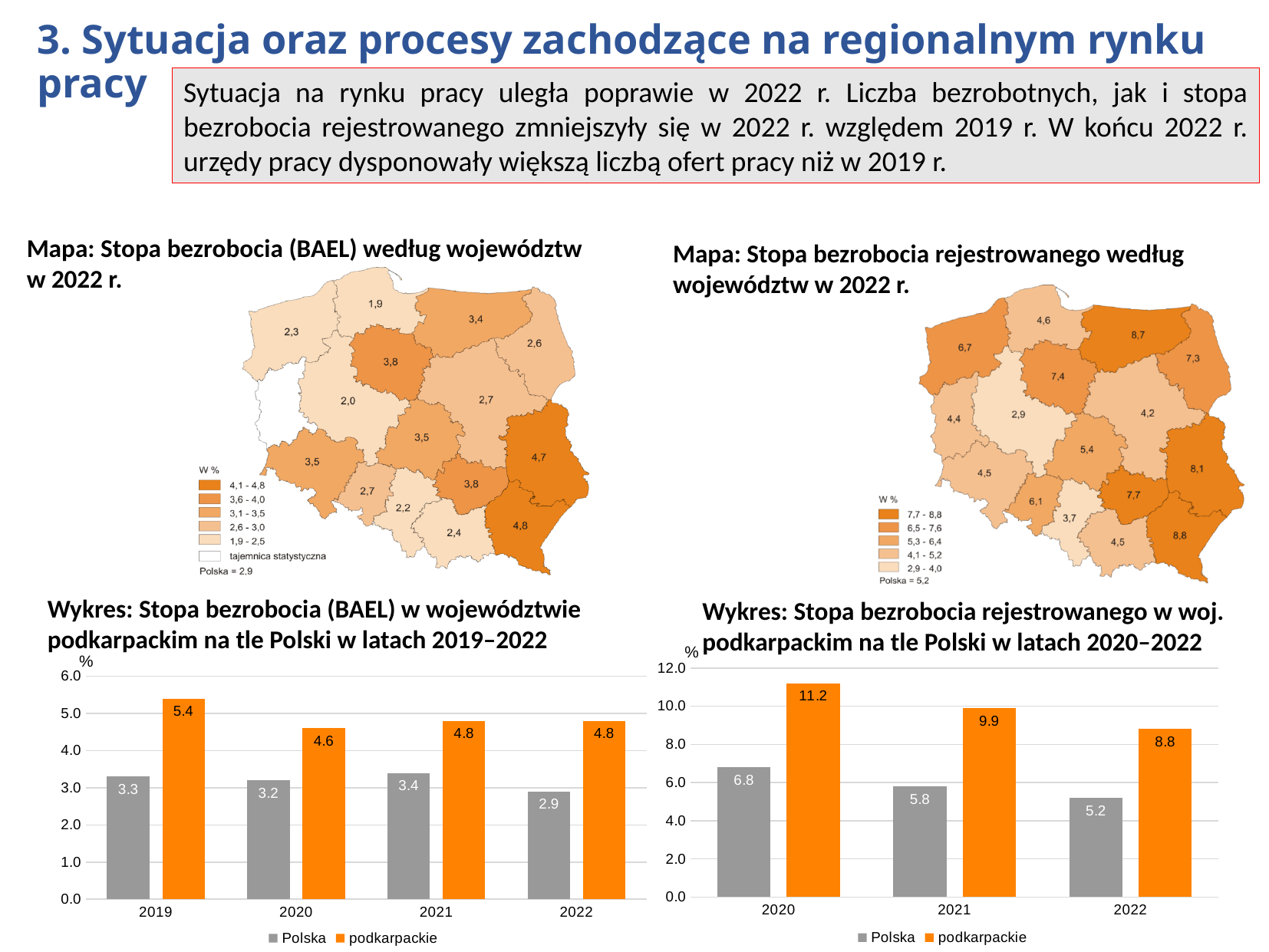
What kind of chart is the bottom-right chart (Stopa bezrobocia rejestrowanego)? bar chart In the bottom-left chart (Stopa bezrobocia (BAEL)), what is the value for Polska in 2022? 2.9 In the bottom-left chart (Stopa bezrobocia (BAEL)), how many years are shown on the x axis? 4 In the bottom-right chart (Stopa bezrobocia rejestrowanego), how many series does the legend list? 2 In the bottom-left chart (Stopa bezrobocia (BAEL)), what is the difference between podkarpackie and Polska in 2021? 1.4 In the bottom-right chart (Stopa bezrobocia rejestrowanego), what is the value for Polska in 2021? 5.8 In the bottom-left chart (Stopa bezrobocia (BAEL) w województwie podkarpackim na tle Polski), what is the value for podkarpackie in 2019? 5.4 In the bottom-right chart (Stopa bezrobocia rejestrowanego), does the value for podkarpackie rise or fall from 2020 to 2022? fall In the bottom-right chart (Stopa bezrobocia rejestrowanego), what is the difference between podkarpackie and Polska in 2022? 3.6 In the bottom-left chart (Stopa bezrobocia (BAEL)), which year has the highest value for podkarpackie? 2019 In the bottom-right chart (Stopa bezrobocia rejestrowanego w woj. podkarpackim na tle Polski), what is the value for podkarpackie in 2020? 11.2 In the bottom-left chart (Stopa bezrobocia (BAEL)), which year has the lowest value for Polska? 2022